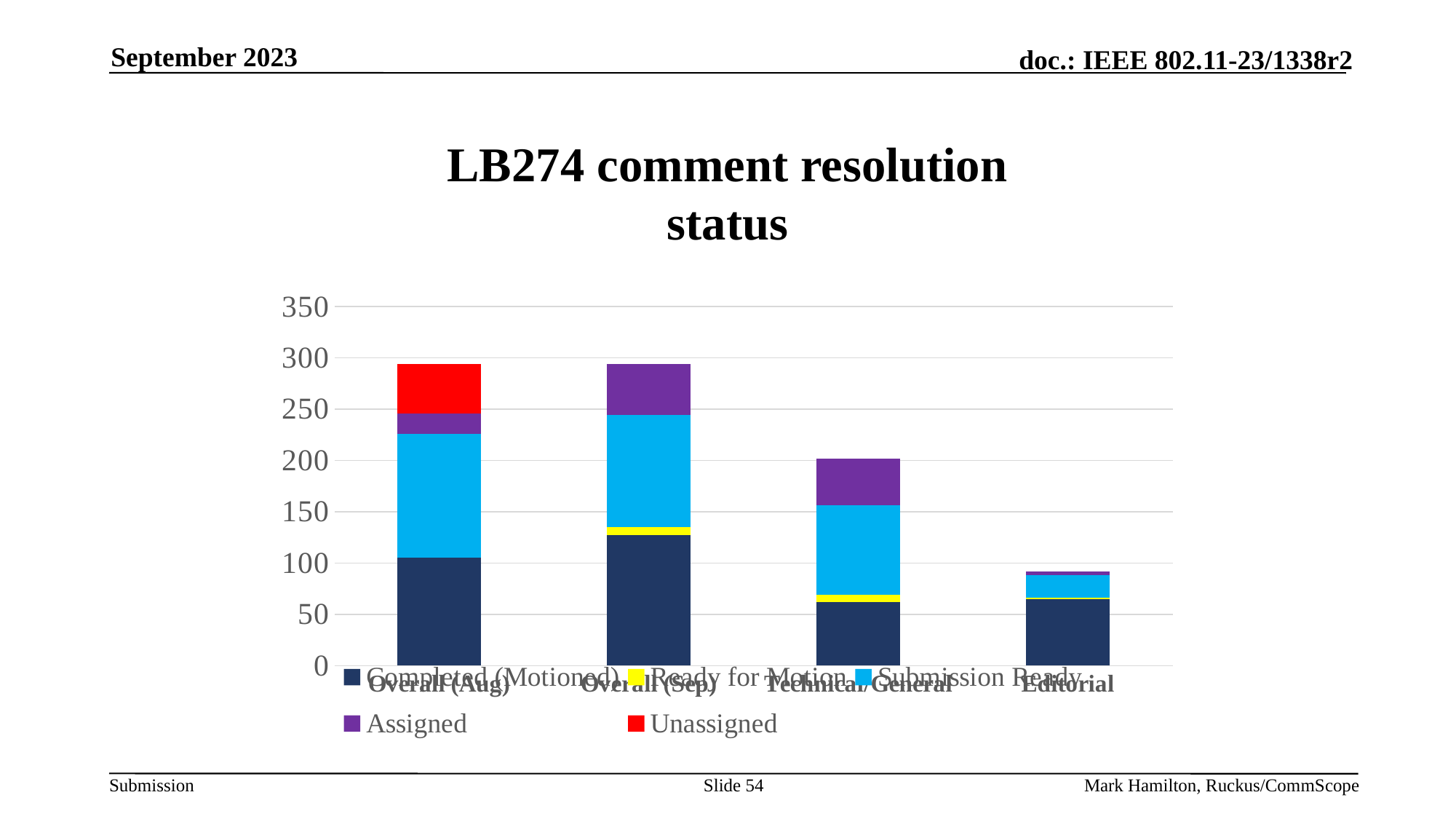
Is the total for Overall (Aug) greater or less than 250? greater Which category has the lowest total bar height? Editorial What kind of chart is shown on the slide? stacked bar chart What is the title of the chart? LB274 comment resolution status Which has the larger total bar, Overall (Sep) or Technical/General? Overall (Sep) Is the total for Technical/General greater or less than 150? greater How many series does the legend list? 5 Is the total for Editorial greater or less than 100? less Which category is the only one with an Unassigned (red) segment? Overall (Aug) Which has the larger total bar, Technical/General or Editorial? Technical/General How many categories are shown on the x axis? 4